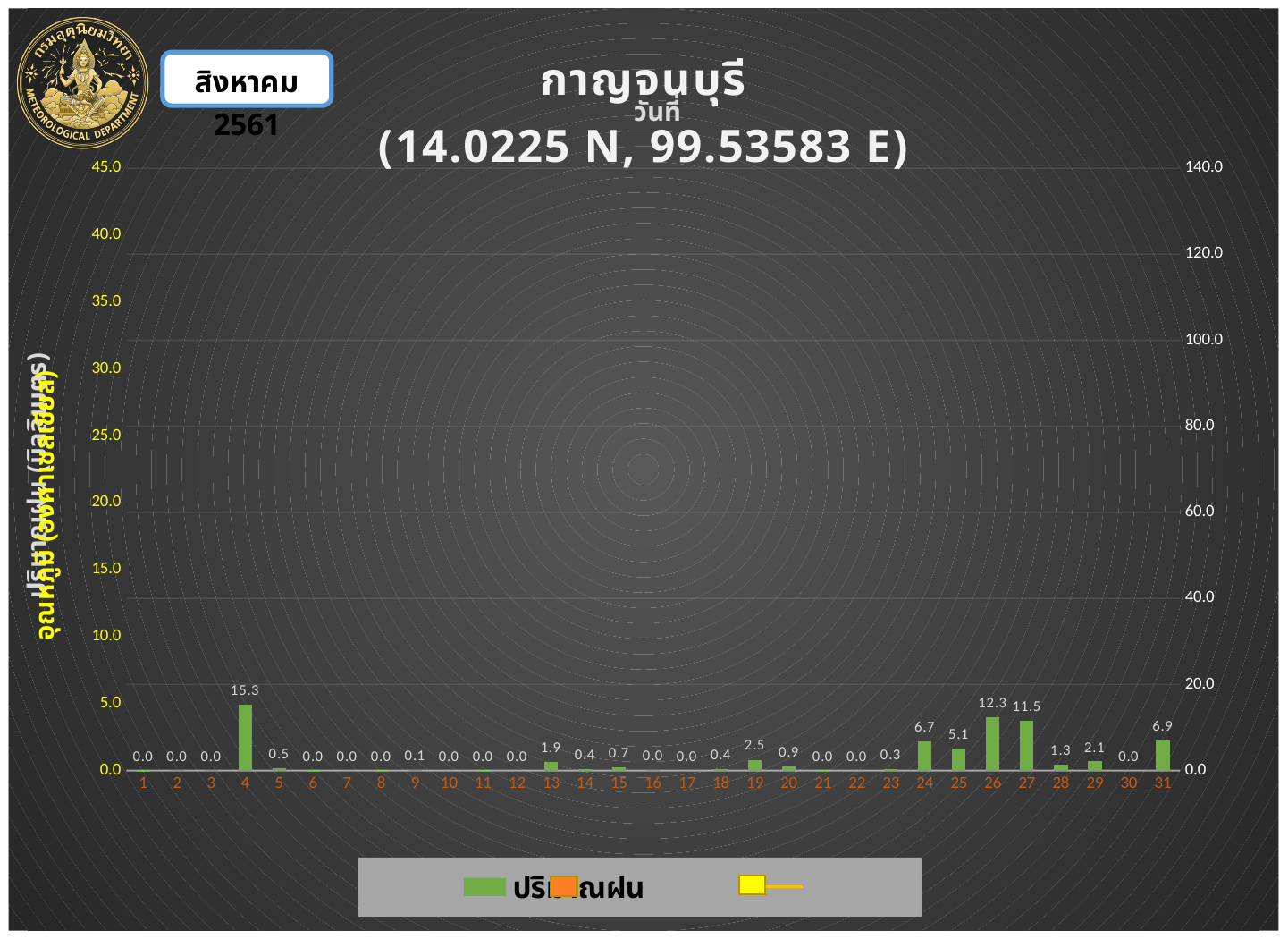
What is the rainfall value shown for day 31? 6.9 What is the rainfall value (ปริมาณฝน) shown for day 4? 15.3 What is the rainfall value shown for day 19? 2.5 Which day has the highest rainfall value? 4 What is the rainfall value shown for day 27? 11.5 What is the name of the station in the chart title? กาญจนบุรี What is the difference between the rainfall values for day 24 and day 25? 1.6 What is the difference between the rainfall values for day 26 and day 27? 0.8 What kind of chart is used to show the rainfall values? bar chart Which day has the larger rainfall value, day 13 or day 29? 29 What is the rainfall value shown for day 26? 12.3 How many days are shown on the x axis? 31